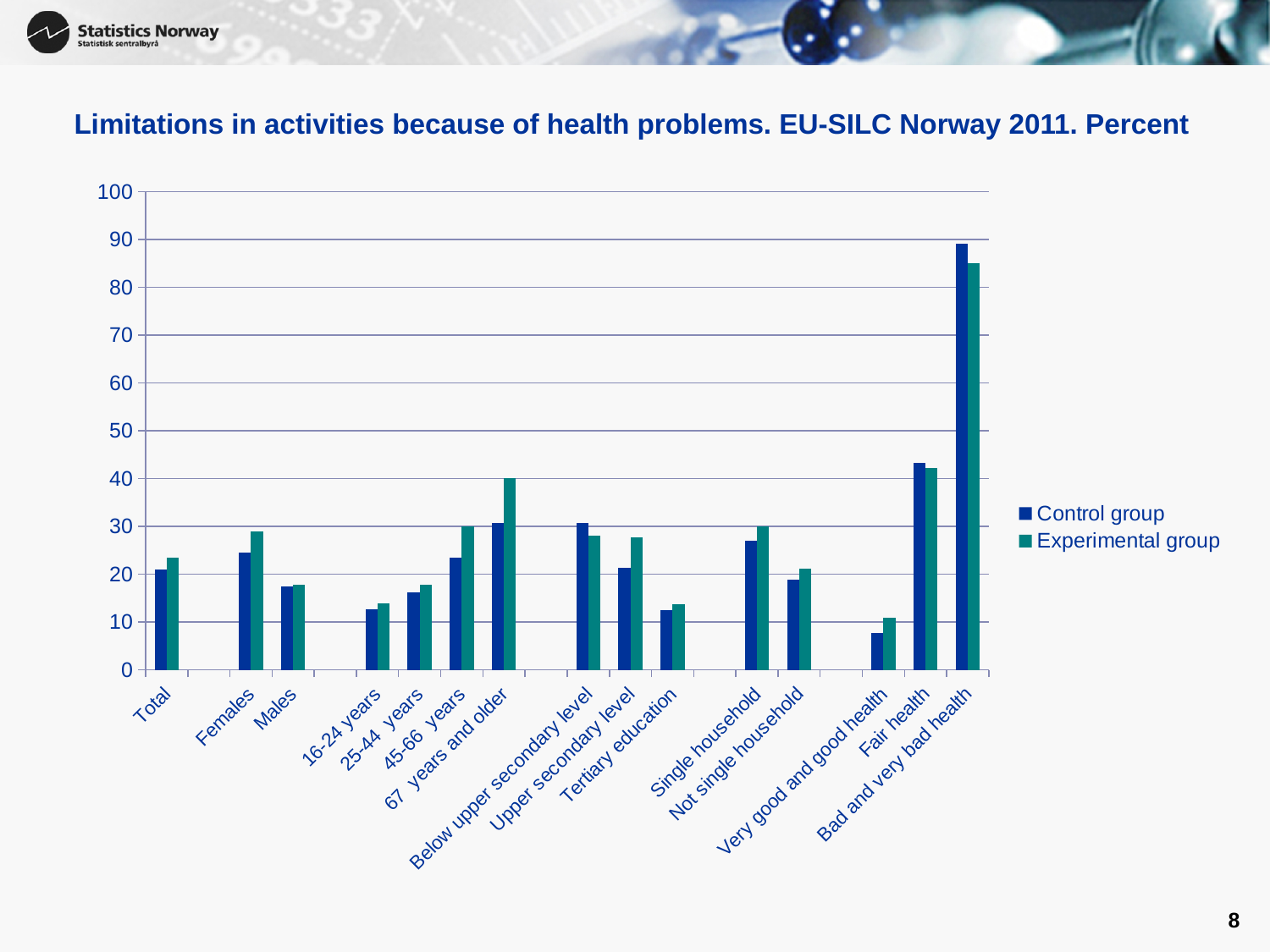
Which category has the highest value for the Control group? Bad and very bad health For 67 years and older, which series has the larger value, Control group or Experimental group? Experimental group For Below upper secondary level, which series has the larger value, Control group or Experimental group? Control group How many series does the legend list? 2 How many categories are shown along the x axis? 15 Is the Control group value for Very good and good health greater or less than 10? less Is the Experimental group value for 67 years and older greater or less than 30? greater Is the Control group value for Males greater or less than 20? less What kind of chart is shown on the slide? Bar chart Which category has the lowest value for the Experimental group? Very good and good health What is the title of the chart? Limitations in activities because of health problems. EU-SILC Norway 2011. Percent